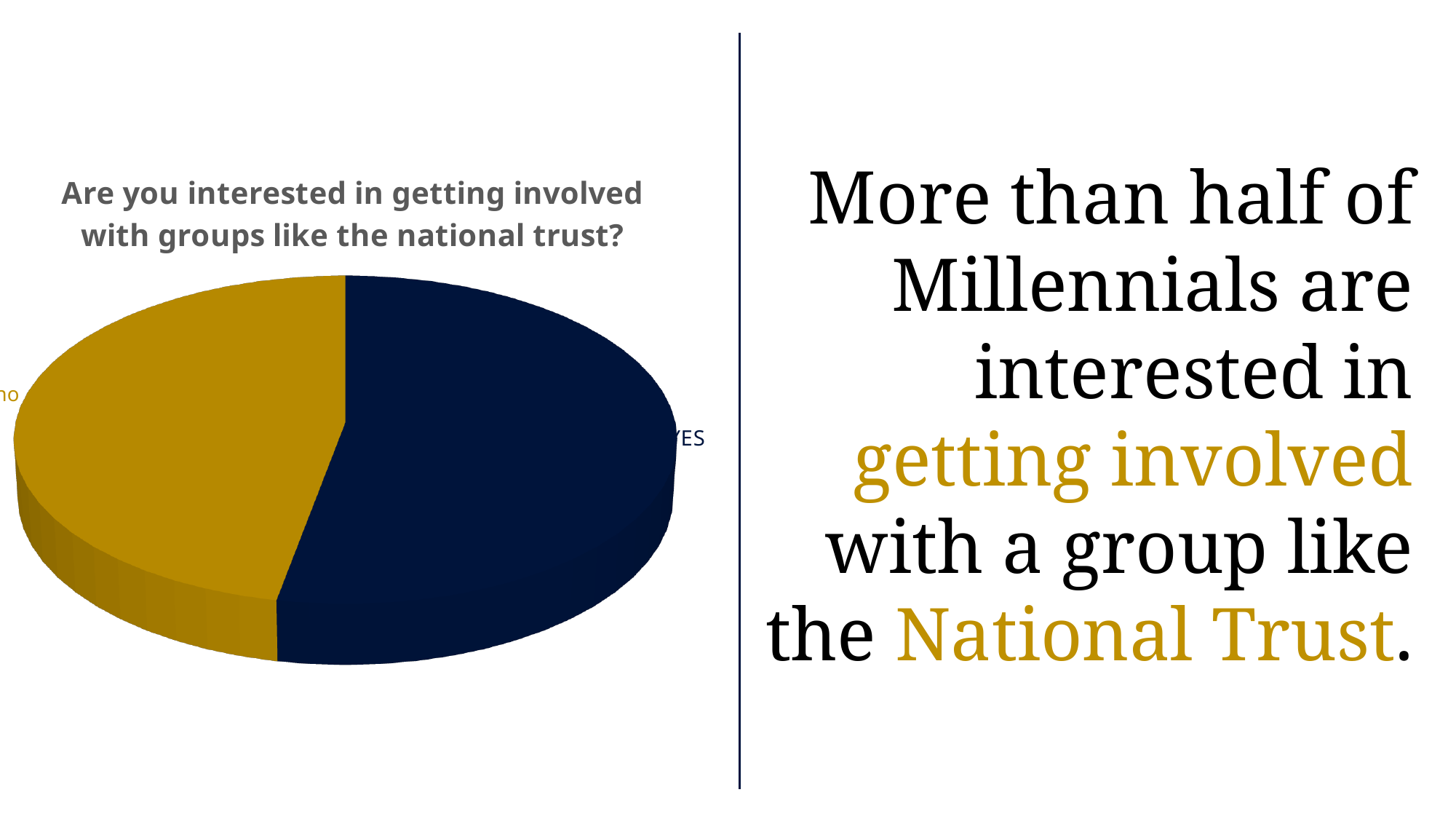
Which slice of the pie chart is smaller, YES or no? no Does the YES slice of the pie chart represent more or less than half of the responses? more Which category does the gold slice of the pie chart represent? no What is the title of the pie chart? Are you interested in getting involved with groups like the national trust? Which slice of the pie chart is larger, YES or no? YES What kind of chart is shown on the slide? pie chart How many slices does the pie chart have? 2